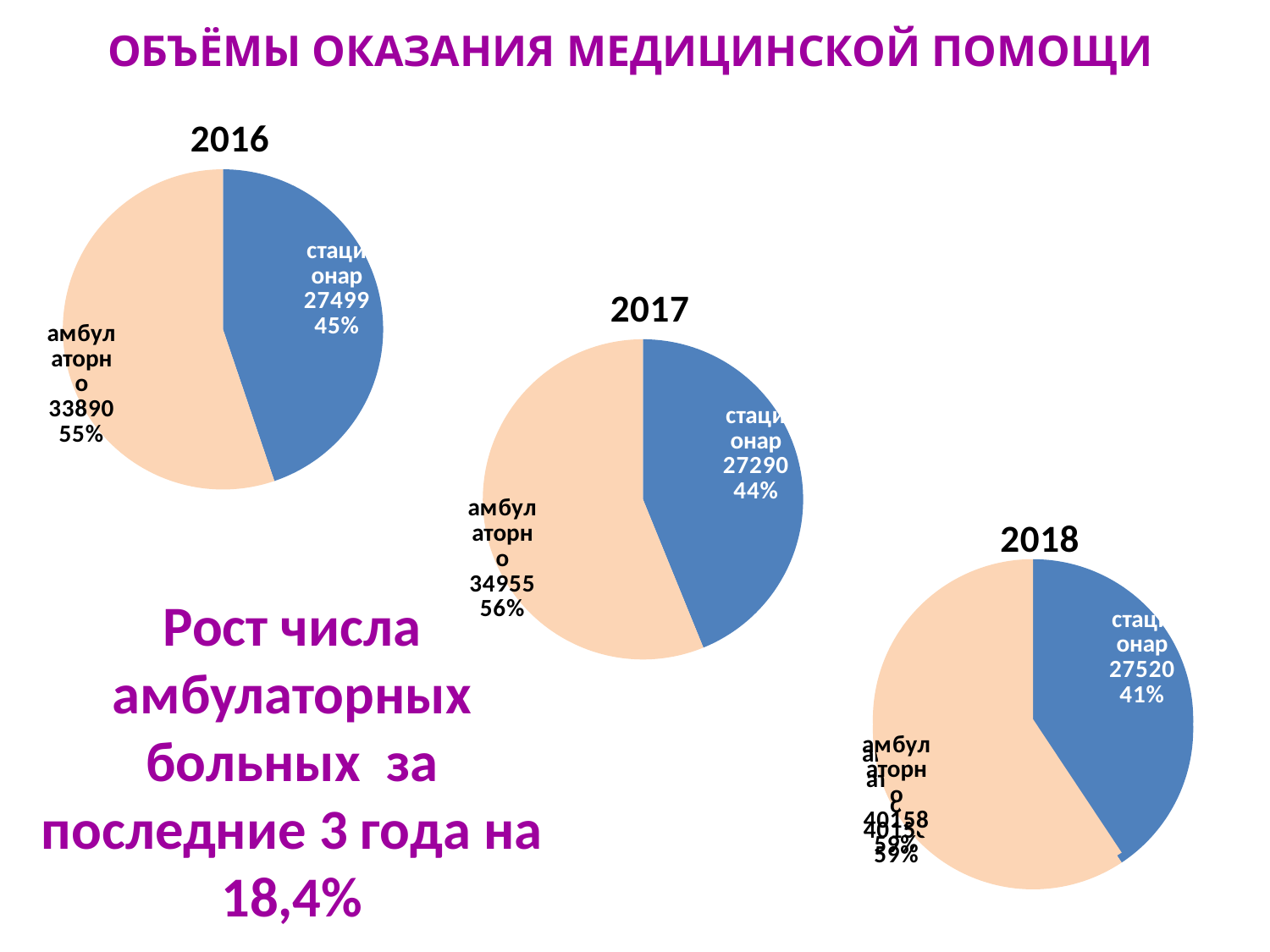
In the 2017 pie chart, what is the value for амбулаторно? 34955 In the 2018 pie chart, what share of the pie does стационар take? 41% In the 2016 pie chart, what is the difference between the амбулаторно and стационар values? 6391 In the 2016 pie chart, what is the value for амбулаторно? 33890 In the 2018 pie chart, what is the value for стационар? 27520 How many pie charts are on the slide? 3 In the 2017 pie chart, which category is larger, стационар or амбулаторно? амбулаторно In the 2016 pie chart, what share of the pie does амбулаторно take? 55% In the 2017 pie chart, what share of the pie does стационар take? 44% In the 2017 pie chart, what is the value for стационар? 27290 What type of charts are shown on the slide? pie charts In the 2016 pie chart, what is the value for стационар? 27499